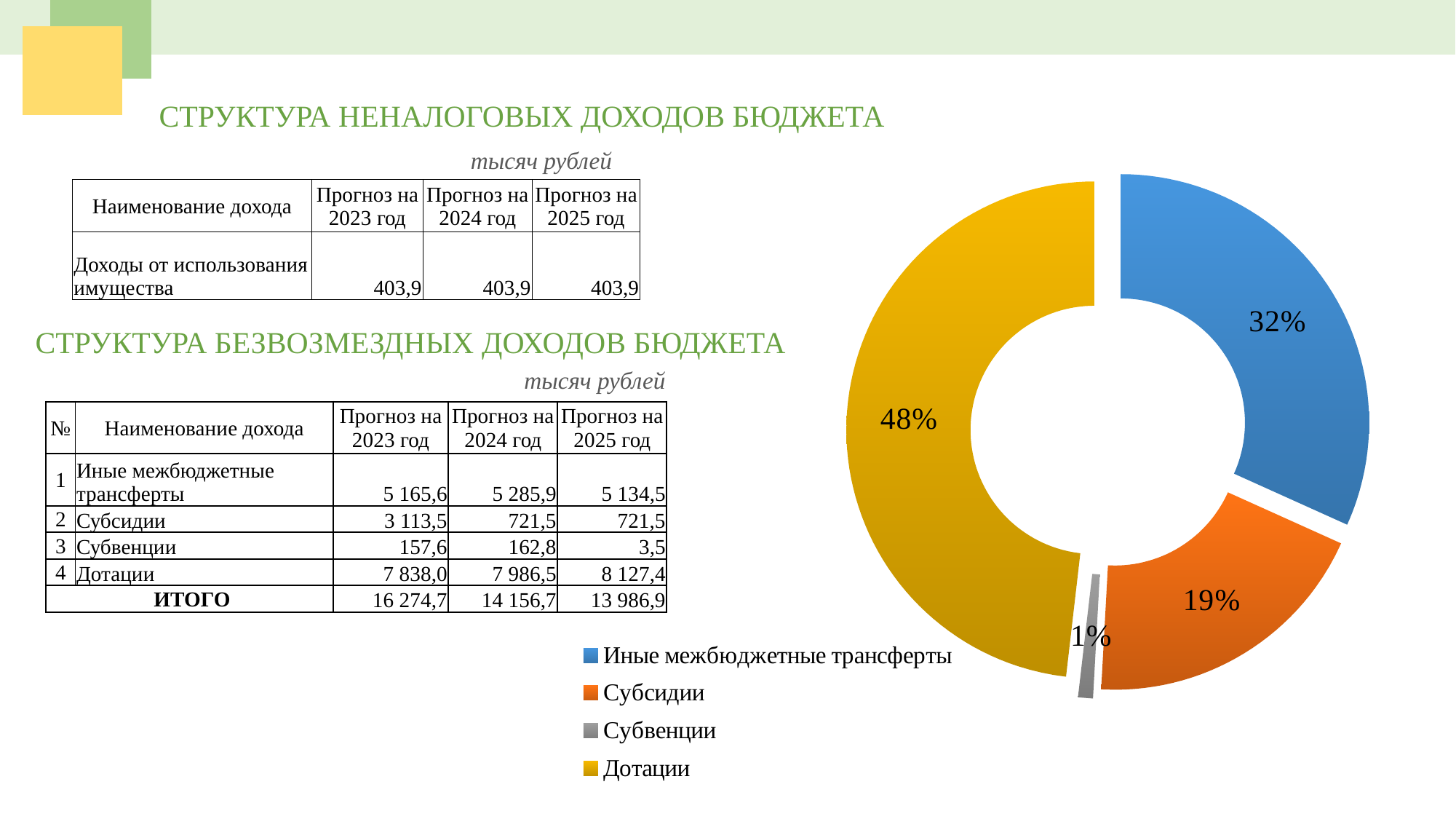
What share of the doughnut chart on the right is labelled for Иные межбюджетные трансферты? 32% In the doughnut chart on the right, what is the difference in percentage points between the Иные межбюджетные трансферты slice and the Субвенции slice? 31% What type of chart is shown on the right of the slide? Doughnut chart In the doughnut chart on the right, what is the difference in percentage points between the Дотации slice and the Субсидии slice? 29% What share of the doughnut chart on the right is labelled for Субвенции? 1% Which category has the smallest slice in the doughnut chart on the right? Субвенции Which category has the largest slice in the doughnut chart on the right? Дотации How many slices does the doughnut chart on the right have? 4 What share of the doughnut chart on the right is labelled for Дотации? 48% In the doughnut chart on the right, which slice is larger: Субсидии or Иные межбюджетные трансферты? Иные межбюджетные трансферты How many entries does the legend of the doughnut chart on the right list? 4